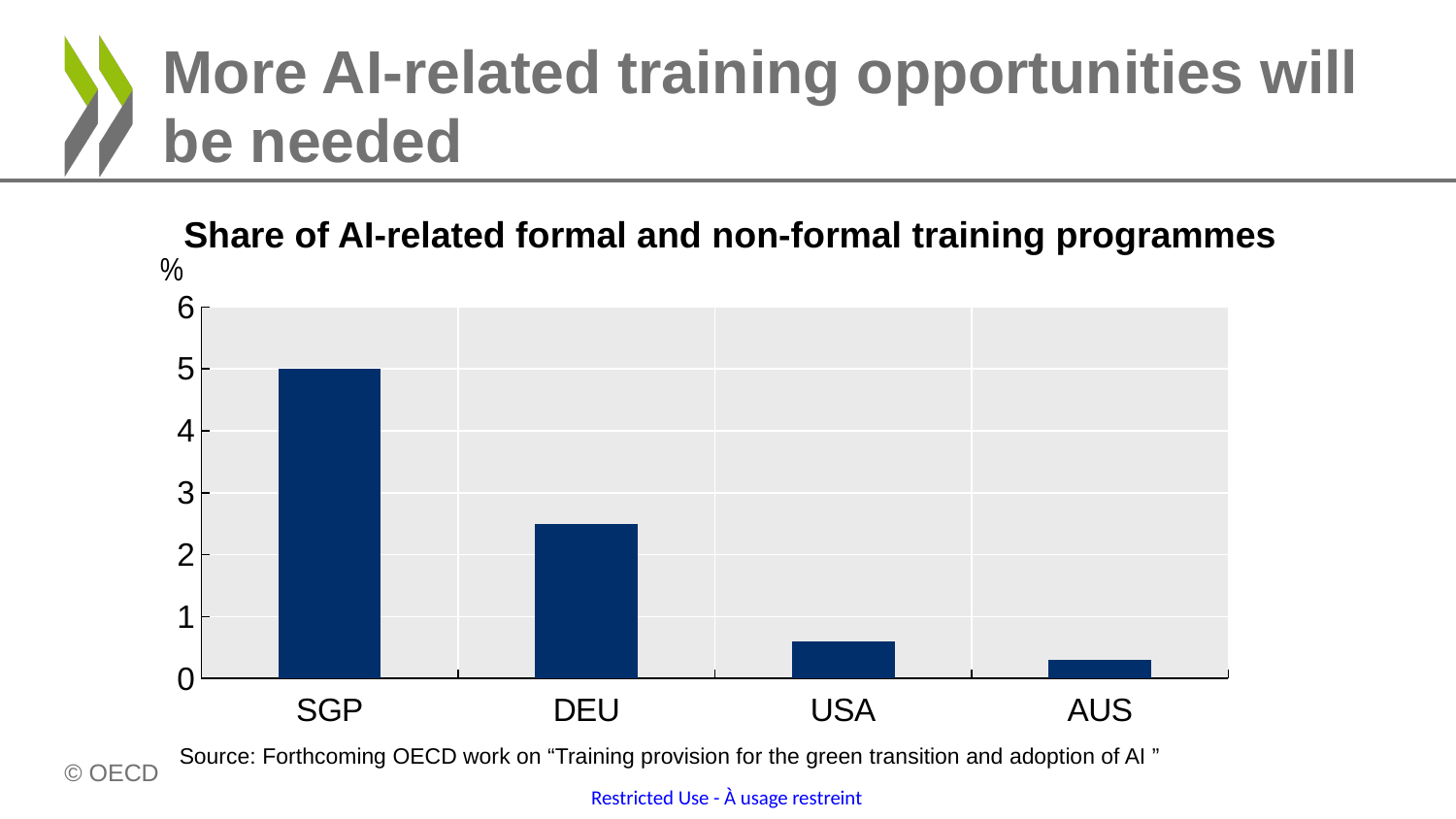
What kind of chart is shown on the slide? bar chart Which country has the highest share of AI-related training programmes? SGP How many countries are shown on the x axis of the chart? 4 Which has a larger share of AI-related training programmes, DEU or USA? DEU Is the value for DEU greater or less than 2? greater What is the share of AI-related training programmes for SGP? 5 Is the value for SGP greater or less than 4? greater What is the title of the chart? Share of AI-related formal and non-formal training programmes Which country has the lowest share of AI-related training programmes? AUS Is the value for USA greater or less than 1? less Do the bar values rise or fall from left to right along the x axis? fall